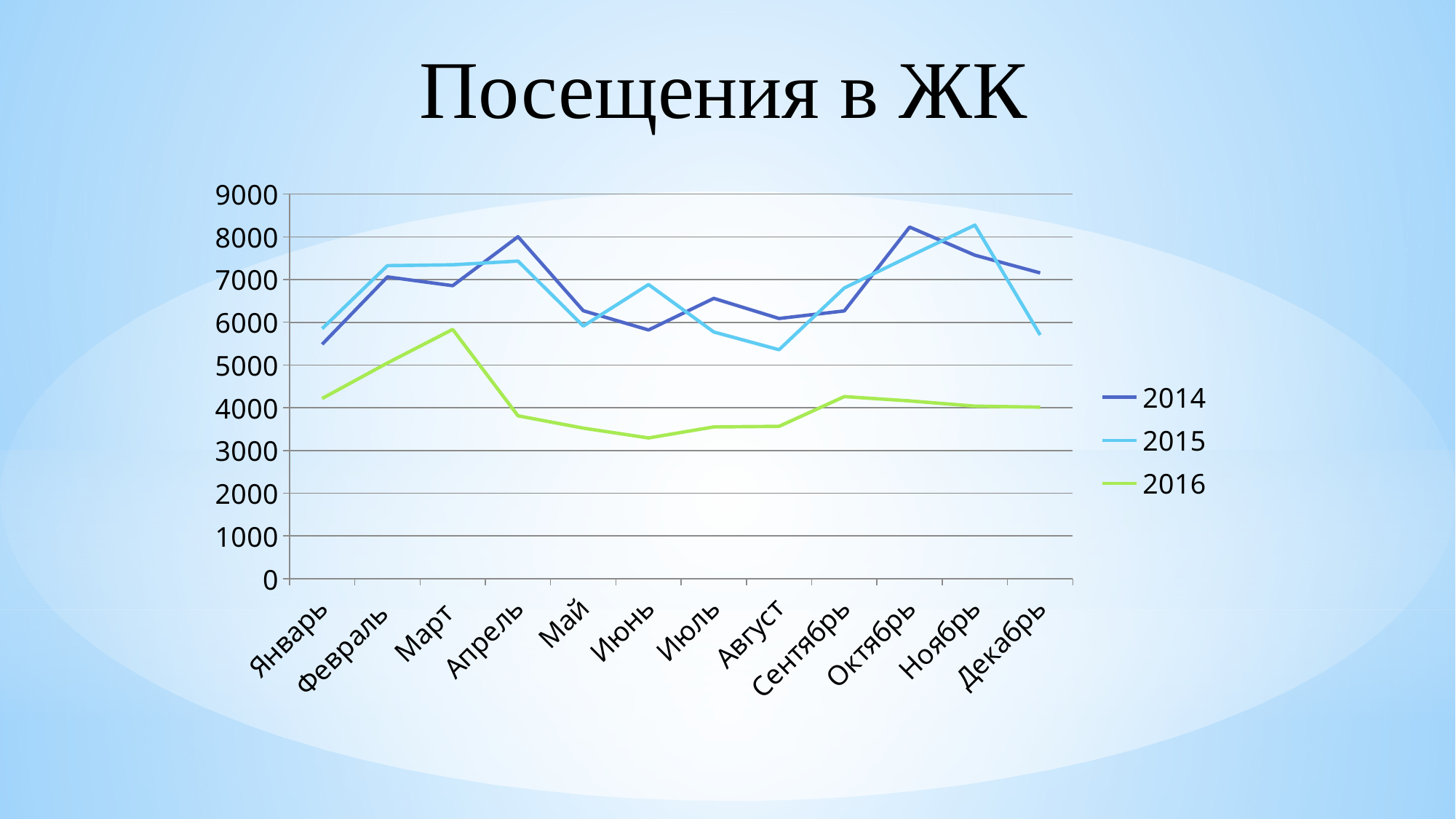
In which month does the 2016 series reach its highest value? Март In Январь, which series has the larger value, 2014 or 2016? 2014 Which years are listed in the legend? 2014, 2015, 2016 In Декабрь, which series has the larger value, 2014 or 2015? 2014 Is the value for 2016 in Июнь greater or less than 4000? less How many months are plotted along the x axis? 12 What kind of chart is shown on the slide? line chart Is the value for 2015 in Август greater or less than 5000? greater How many series does the legend list? 3 Is the value for 2014 in Апрель greater or less than 7000? greater What is the title of the chart? Посещения в ЖК In which month does the 2015 series reach its highest value? Ноябрь